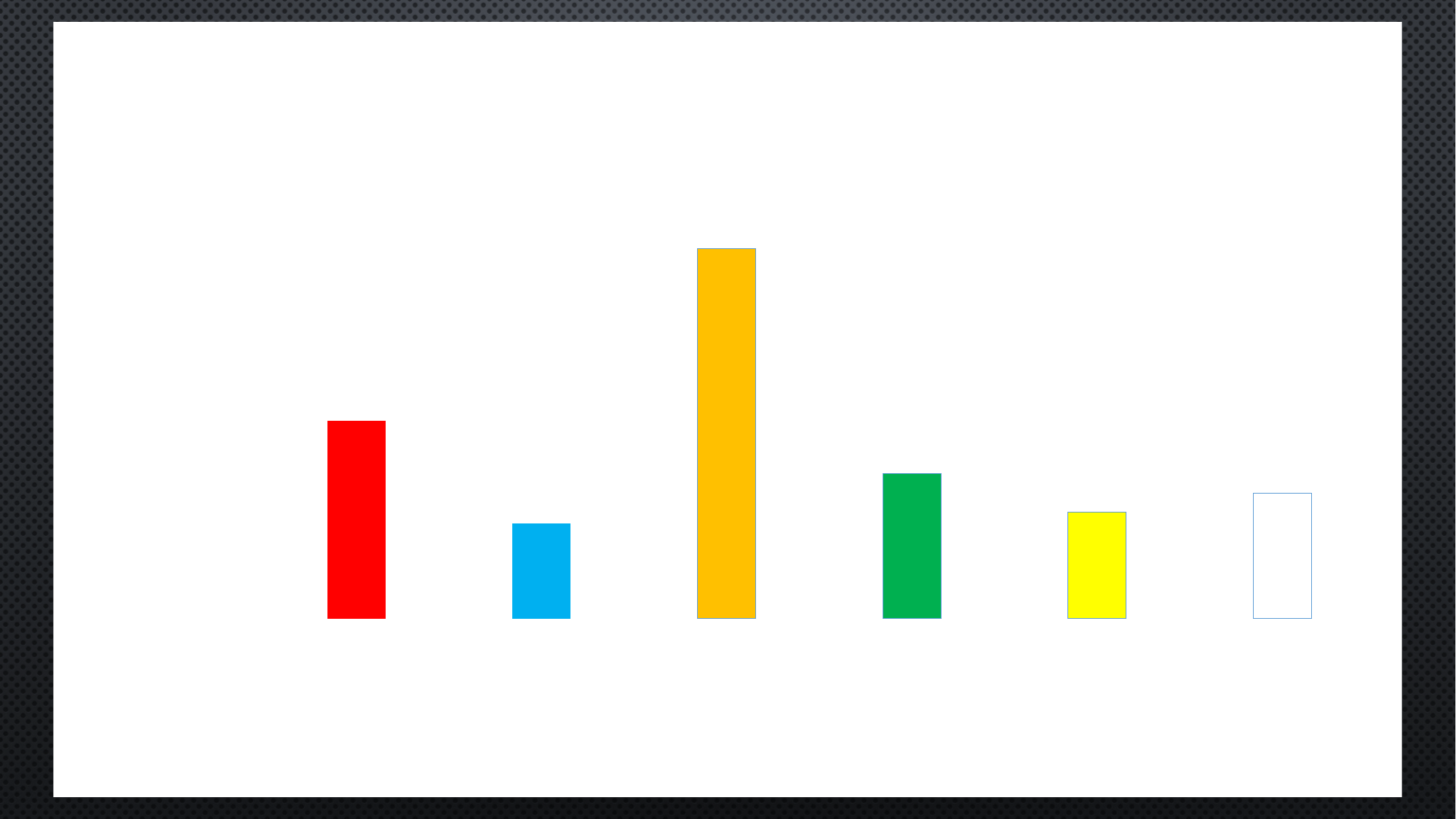
Which bar is taller, the red bar or the green bar? the red bar Which bar is shorter, the blue bar or the white bar? the blue bar How many bars does the chart contain? 6 Which bar is taller, the green bar or the yellow bar? the green bar Which bar is the tallest in the chart? the orange bar (third from left) What colour is the tallest bar in the chart? orange Does the chart display a title, axis labels or a legend? No What kind of chart is shown on the slide? bar chart